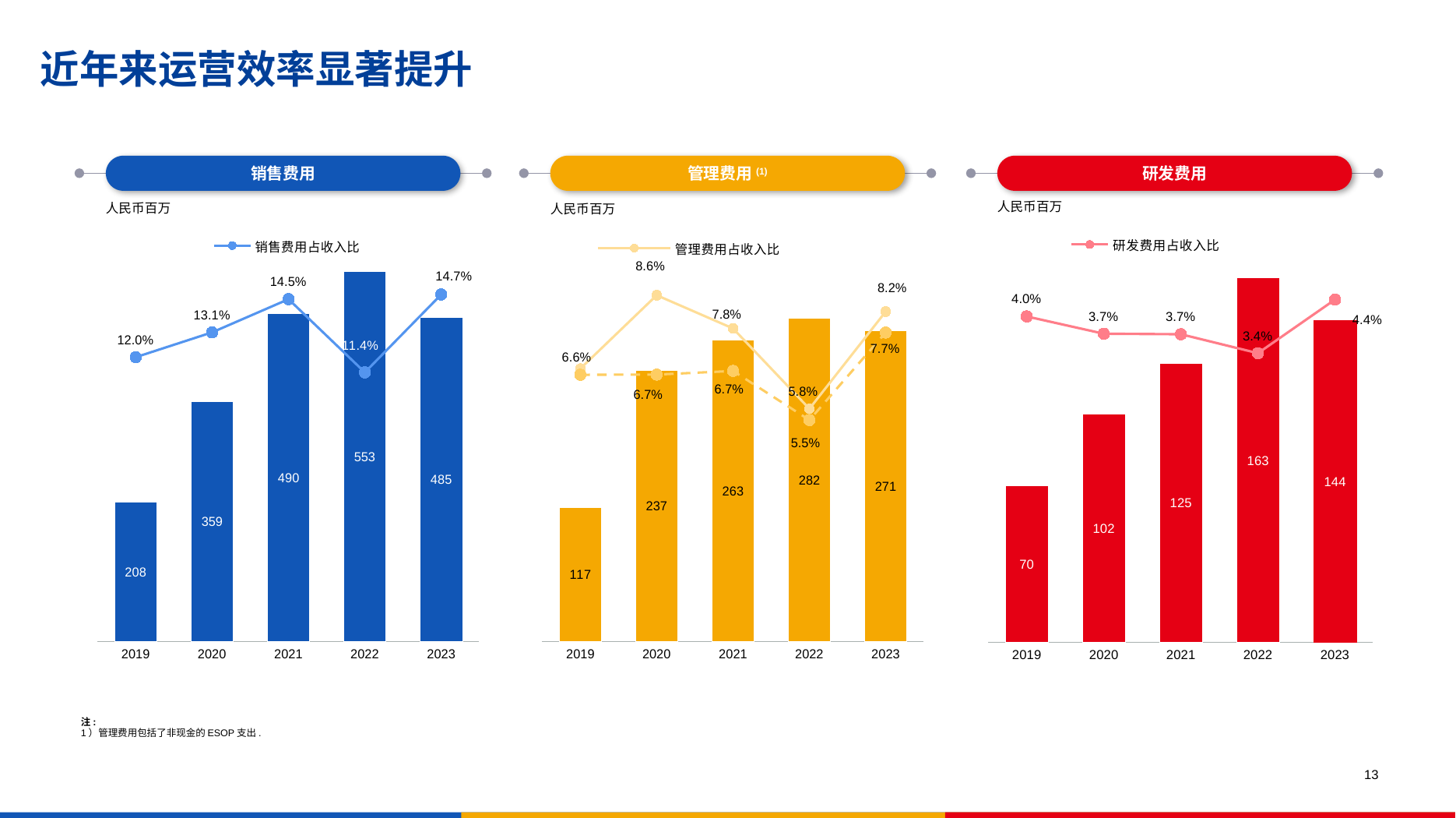
In the 销售费用 chart, which year has the lowest bar? 2019 In the 研发费用 chart, which is larger, the bar for 2021 or the bar for 2023? 2023 In the 销售费用 chart, what is the difference between the bar values for 2021 and 2020? 131 In the 研发费用 chart, what is the value of the bar for 2022? 163 In the 研发费用 chart, what is the 研发费用占收入比 value for 2023? 4.4% In the 管理费用 chart, which year has the highest bar? 2022 In the 销售费用 chart, what is the 销售费用占收入比 value for 2023? 14.7% In the 管理费用 chart, how many years are shown on the x axis? 5 In the 销售费用 chart, what is the value of the bar for 2022? 553 What kind of chart is the 研发费用 chart? Bar chart with a line In the 研发费用 chart, what is the difference between the bar values for 2022 and 2019? 93 In the 管理费用 chart, what is the value of the bar for 2019? 117